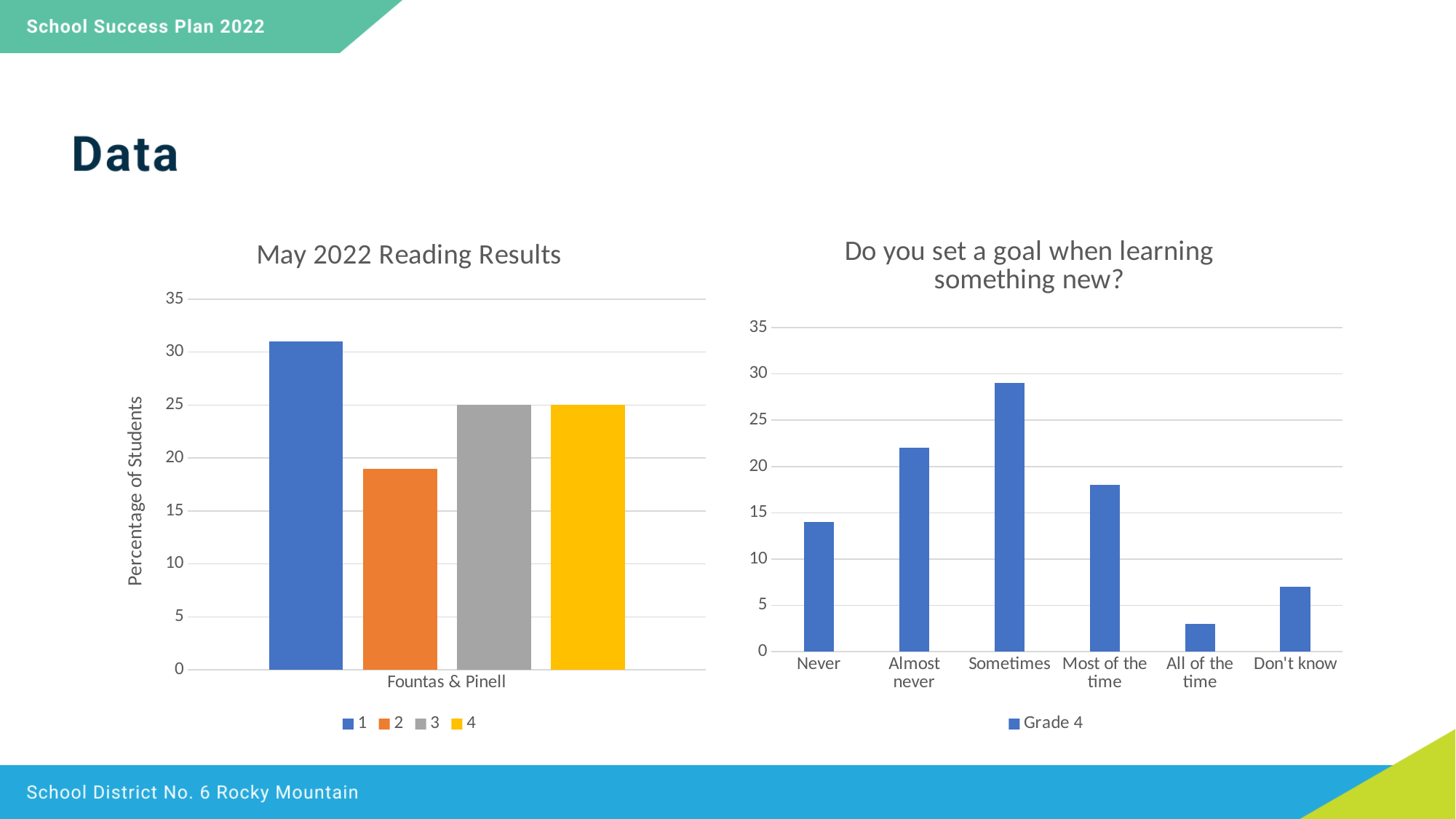
In the "May 2022 Reading Results" chart, which series has the lowest bar? 2 In the "Do you set a goal when learning something new?" chart, how many categories are shown on the x axis? 6 In the "Do you set a goal when learning something new?" chart, which category has the highest bar? Sometimes In the "May 2022 Reading Results" chart, is the value for series 2 greater or less than 20? less In the "May 2022 Reading Results" chart, which series has the highest bar? 1 In the "Do you set a goal when learning something new?" chart, which is larger: the value for "Never" or the value for "Most of the time"? Most of the time In the "Do you set a goal when learning something new?" chart, is the value for "Almost never" greater or less than 20? greater In the "May 2022 Reading Results" chart, is the value for series 1 greater or less than 30? greater What kind of chart is the "May 2022 Reading Results" chart? bar chart In the "Do you set a goal when learning something new?" chart, which category has the lowest bar? All of the time What is the y-axis title of the "May 2022 Reading Results" chart? Percentage of Students In the "May 2022 Reading Results" chart, how many series does the legend list? 4